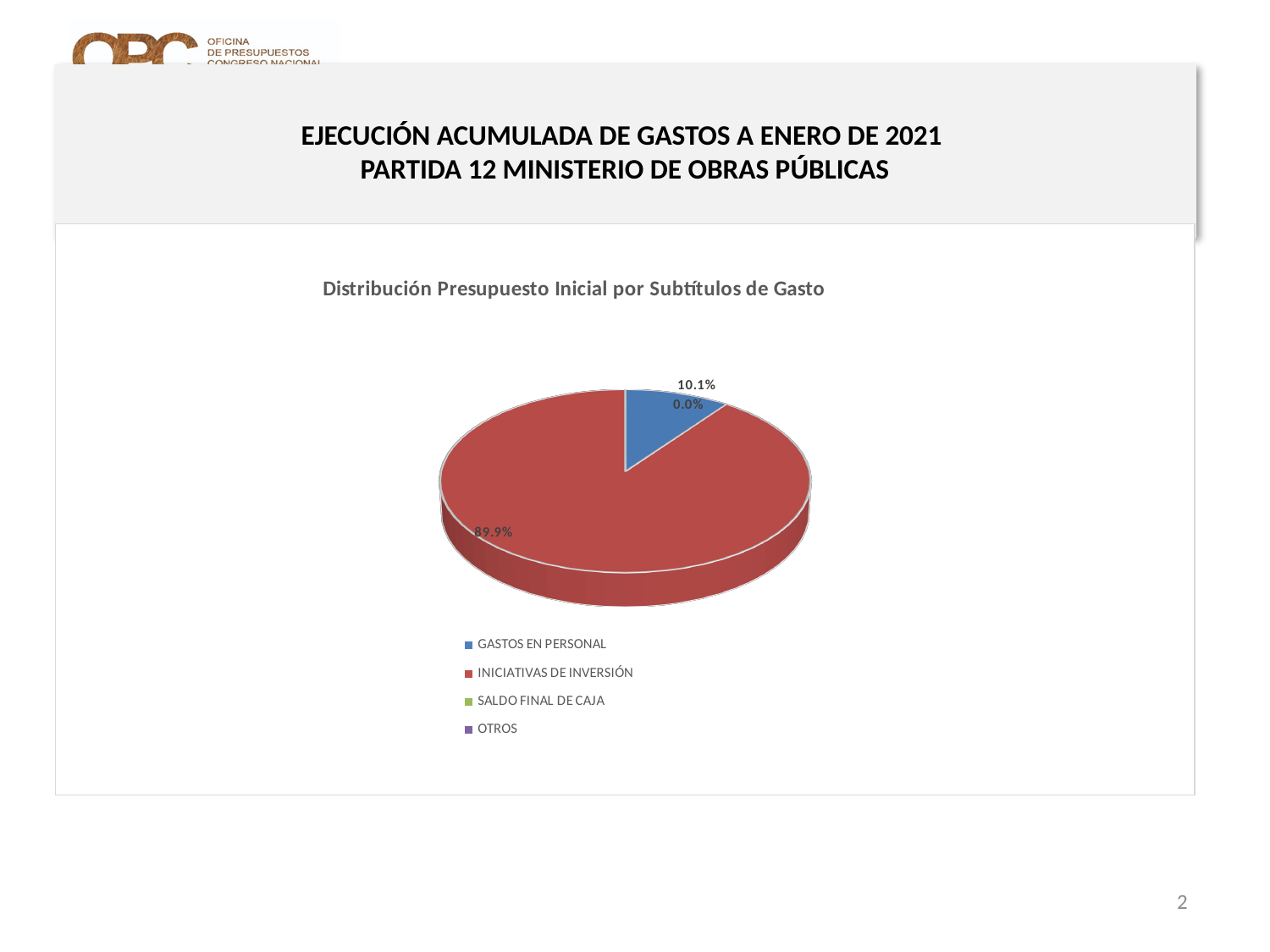
How many categories does the legend list? 4 What is the combined share of GASTOS EN PERSONAL and INICIATIVAS DE INVERSIÓN? 100.0% Which category has the largest slice of the pie? INICIATIVAS DE INVERSIÓN What colour is the slice for INICIATIVAS DE INVERSIÓN? Red Is the share for INICIATIVAS DE INVERSIÓN greater or less than 50%? greater What share of the pie does INICIATIVAS DE INVERSIÓN represent? 89.9% What is the title of the chart? Distribución Presupuesto Inicial por Subtítulos de Gasto What is the difference in percentage points between the INICIATIVAS DE INVERSIÓN slice and the GASTOS EN PERSONAL slice? 79.8 percentage points Which is larger, the slice for GASTOS EN PERSONAL or the slice for INICIATIVAS DE INVERSIÓN? INICIATIVAS DE INVERSIÓN What share of the pie does GASTOS EN PERSONAL represent? 10.1% What kind of chart is shown on the slide? Pie chart